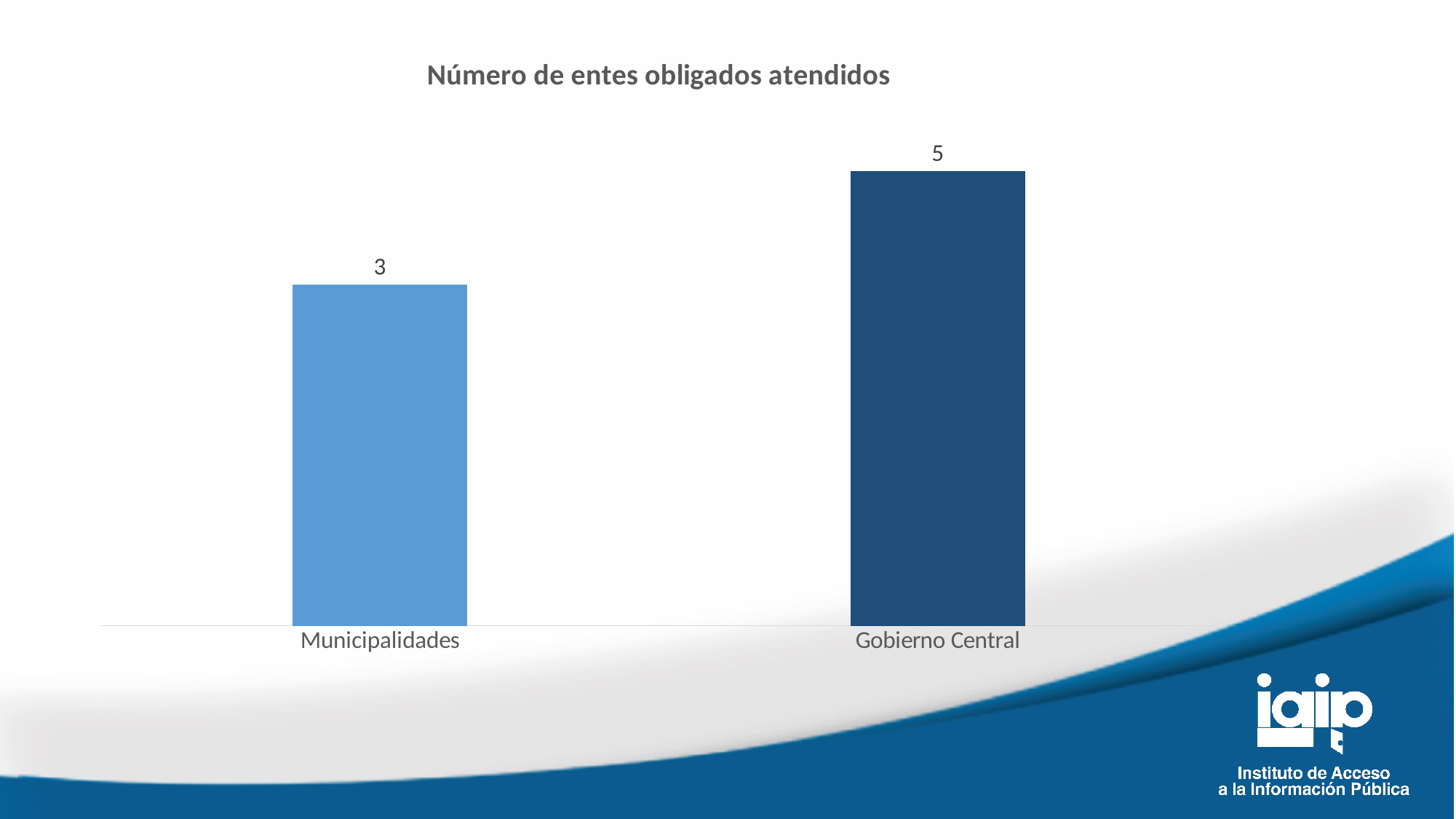
What is the value for Municipalidades? 3 What is the title of the chart? Número de entes obligados atendidos What is the difference between the values for Gobierno Central and Municipalidades? 2 Which category has the lowest value? Municipalidades Which category has the highest value? Gobierno Central What is the total of the values for Municipalidades and Gobierno Central? 8 Which is larger, the value for Municipalidades or the value for Gobierno Central? Gobierno Central Which bar is darker in colour, Municipalidades or Gobierno Central? Gobierno Central What kind of chart is shown on the slide? Bar chart How many categories are shown in the chart? 2 What is the value for Gobierno Central? 5